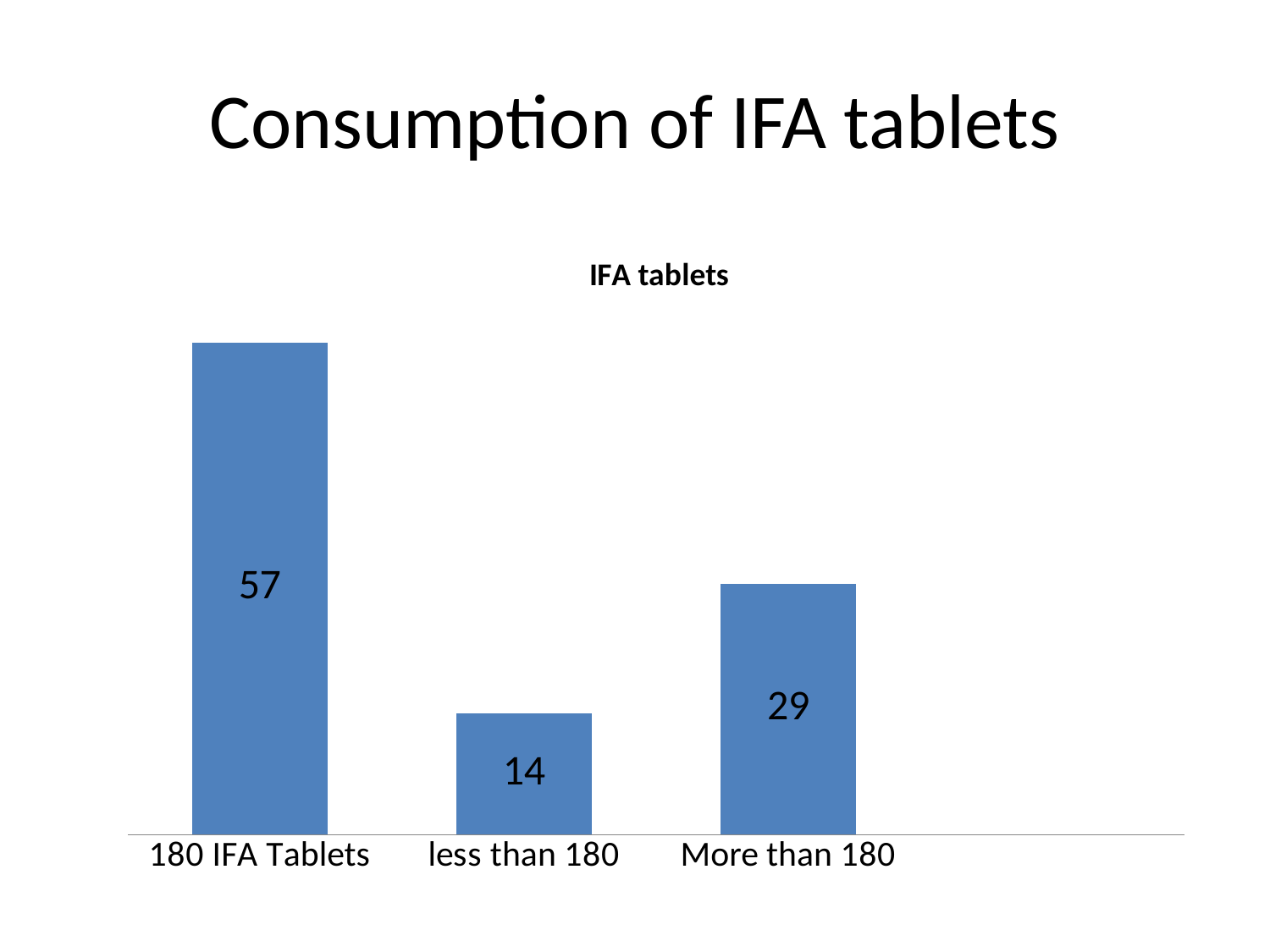
Which category has the highest value? 180 IFA Tablets Which is larger, the value for less than 180 or the value for More than 180? More than 180 Which category has the lowest value? less than 180 What is the difference between the values for 180 IFA Tablets and More than 180? 28 What is the value for less than 180? 14 What is the title of the chart? IFA tablets What kind of chart is shown on the slide? bar chart What is the value for 180 IFA Tablets? 57 How many categories are shown in the chart? 3 What is the difference between the values for More than 180 and less than 180? 15 What is the value for More than 180? 29 What is the total of all three bars in the chart? 100